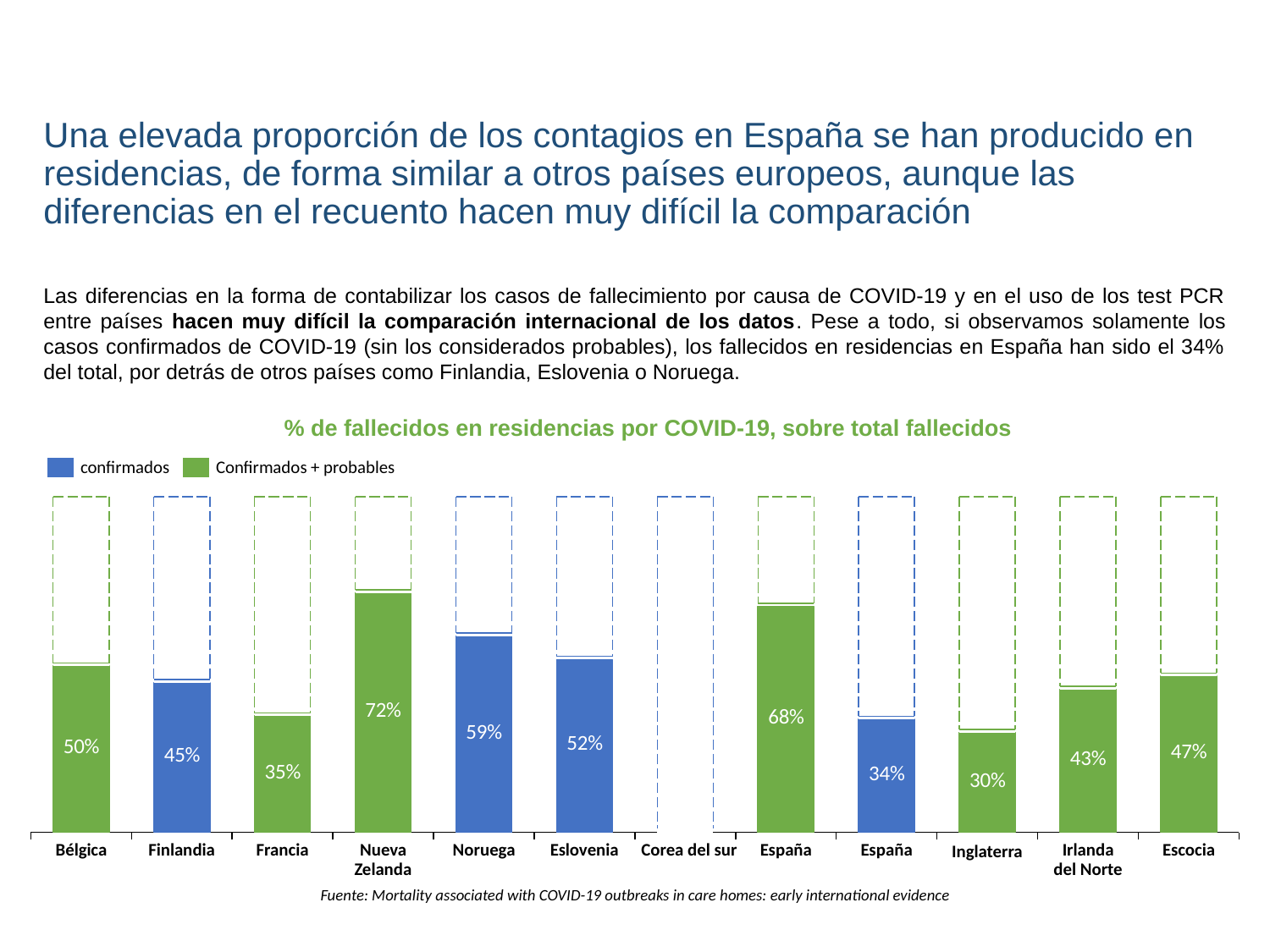
Among the bars with a printed value, which country has the lowest value? Inglaterra Which country has the highest value in the chart? Nueva Zelanda What is the title of the chart? % de fallecidos en residencias por COVID-19, sobre total fallecidos What is the value shown for Nueva Zelanda? 72% What is the value shown for the España bar in the 'Confirmados + probables' series (green)? 68% What is the difference between the two España bars (Confirmados + probables minus confirmados)? 34 percentage points What is the value shown for Finlandia? 45% What is the difference between the value for Nueva Zelanda and the value for Inglaterra? 42 percentage points What is the value shown for the España bar in the 'confirmados' series (blue)? 34% How many series does the legend list? 2 Which is larger, the value for Noruega or the value for Eslovenia? Noruega What kind of chart is shown on the slide? Bar chart